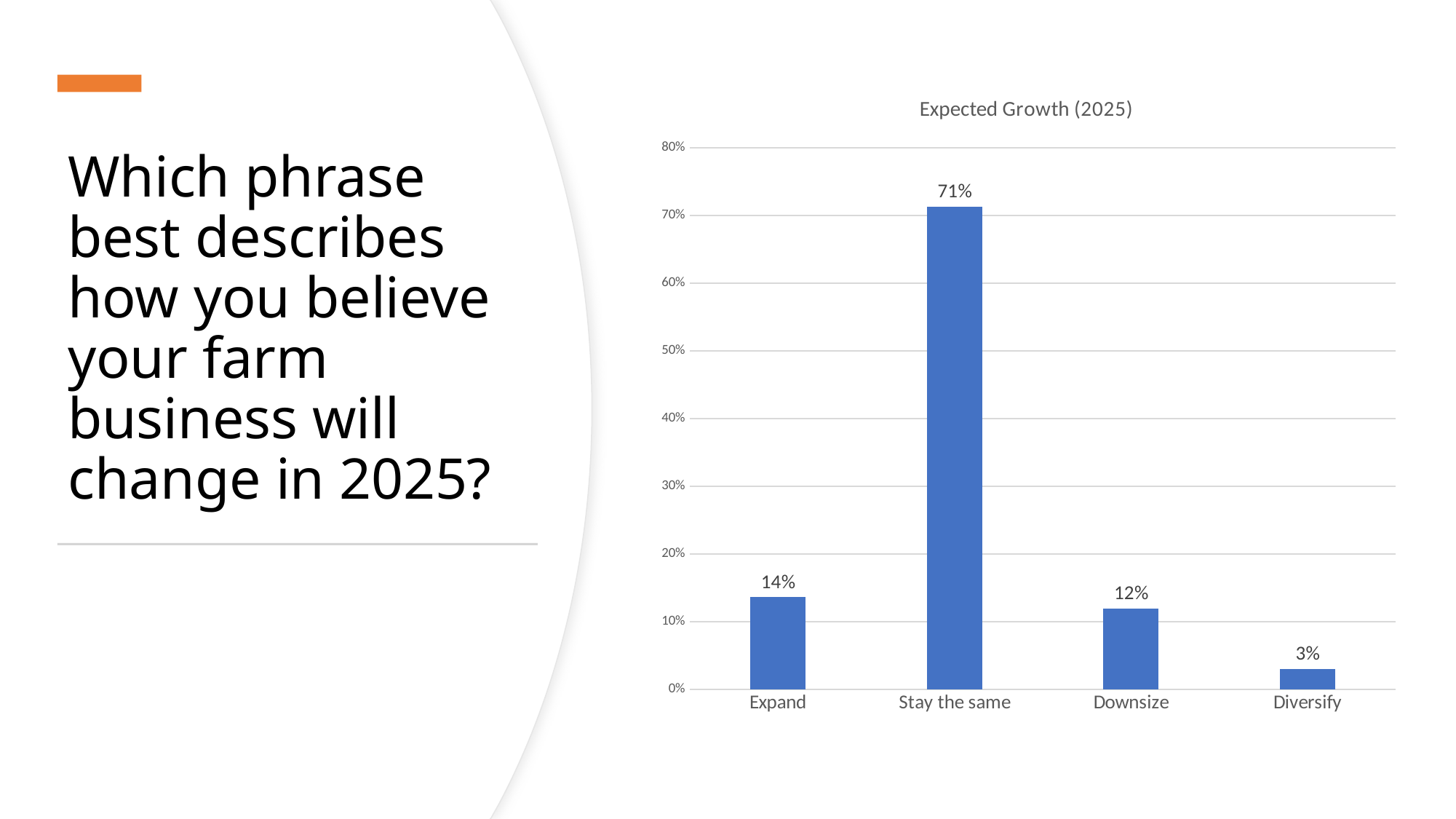
What is the value for Downsize? 12% What is the value for Expand? 14% Which is larger, the value for Expand or the value for Downsize? Expand Which category has the lowest value? Diversify How many categories are shown on the x axis? 4 Is the value for Stay the same greater or less than 60%? greater What is the value for Stay the same? 71% What kind of chart is shown on the slide? Bar chart What is the title of the chart? Expected Growth (2025) What is the value for Diversify? 3% What is the difference between the values for Stay the same and Expand? 57% Which category has the highest value? Stay the same